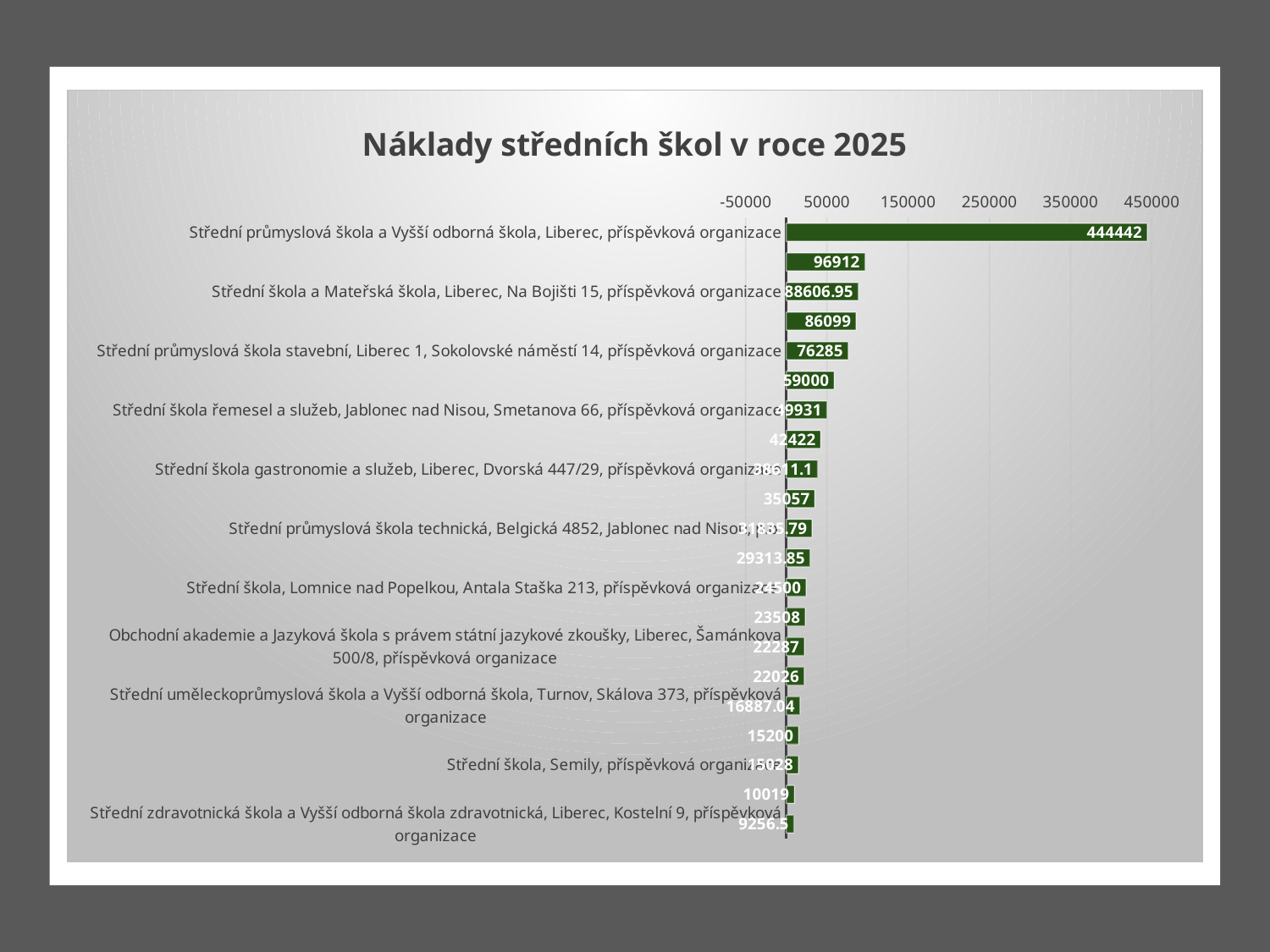
Is the value for Střední škola gastronomie a služeb, Liberec, Dvorská 447/29 greater or less than 50000? less What is the value for Střední průmyslová škola a Vyšší odborná škola, Liberec, příspěvková organizace? 444442 What is the difference between the value for Střední průmyslová škola a Vyšší odborná škola, Liberec and the value for Střední průmyslová škola stavební, Liberec 1? 368157 Which school has the lowest value in the chart? Střední zdravotnická škola a Vyšší odborná škola zdravotnická, Liberec, Kostelní 9, příspěvková organizace What is the value for Střední škola a Mateřská škola, Liberec, Na Bojišti 15, příspěvková organizace? 88606.95 Which school has the highest value in the chart? Střední průmyslová škola a Vyšší odborná škola, Liberec, příspěvková organizace Which has the larger value: Střední průmyslová škola stavební, Liberec 1 or Obchodní akademie a Jazyková škola s právem státní jazykové zkoušky, Liberec? Střední průmyslová škola stavební, Liberec 1 What is the value for Střední uměleckoprůmyslová škola a Vyšší odborná škola, Turnov, Skálova 373, příspěvková organizace? 16887.04 How many bars are plotted in the chart? 21 What is the value for Střední průmyslová škola stavební, Liberec 1, Sokolovské náměstí 14, příspěvková organizace? 76285 What kind of chart is shown on the slide? Bar chart What is the title of the chart? Náklady středních škol v roce 2025